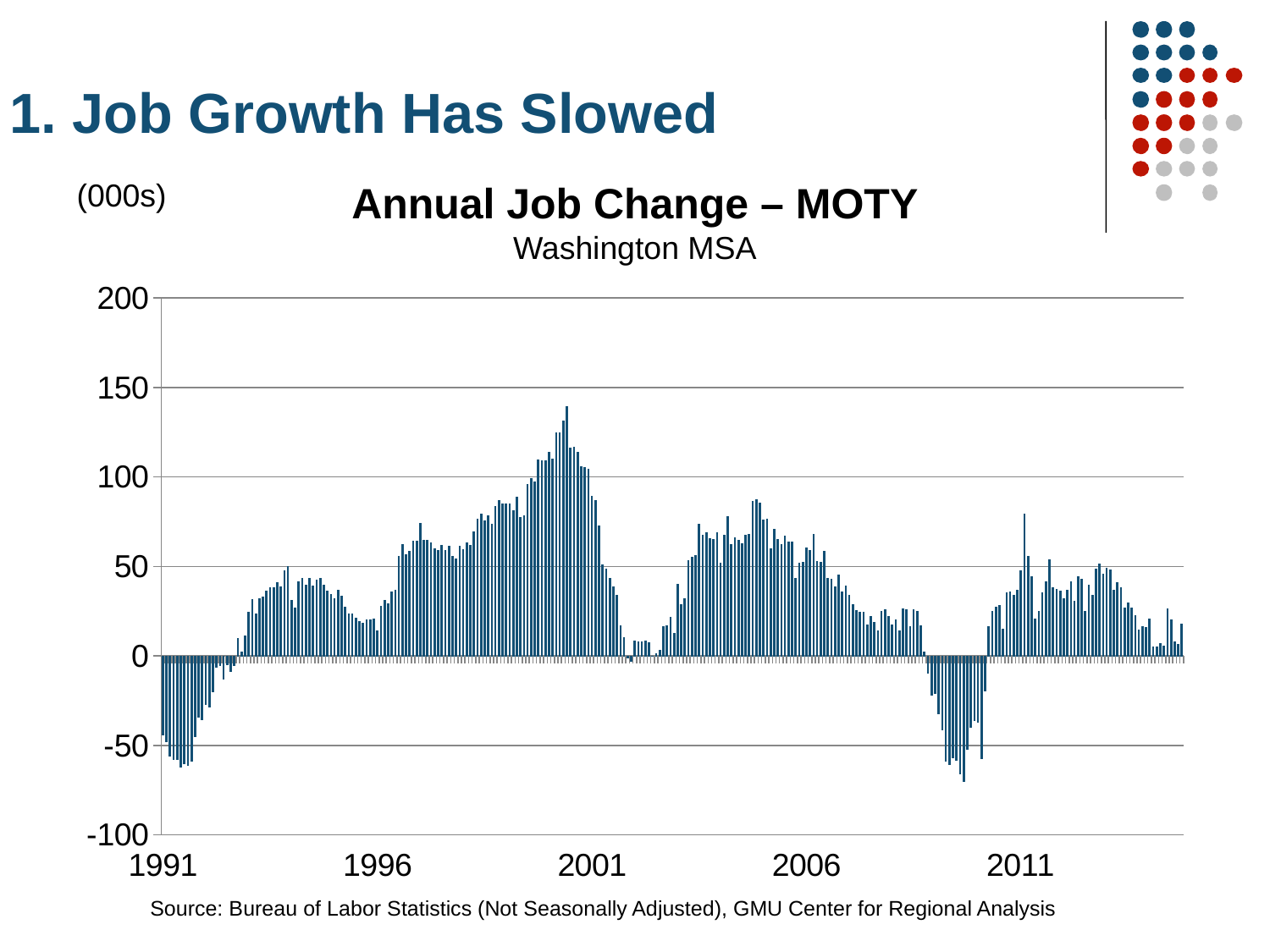
Which period has the higher peak: around 2000 or around 2005? around 2000 What kind of chart is shown on the slide? bar chart What is the title of the chart? Annual Job Change – MOTY Is the highest bar on the chart, around 2000, greater or less than 100? greater Is the peak of the bars around 2005 greater or less than 50? greater Are the bars at the start of the chart in 1991 greater or less than 0? less Do the bars generally rise or fall from 1997 to 2000? rise Which metropolitan area does the chart cover, according to its subtitle? Washington MSA What is the highest value shown on the vertical axis? 200 Do the bars generally rise or fall from 2012 to the end of the chart? fall